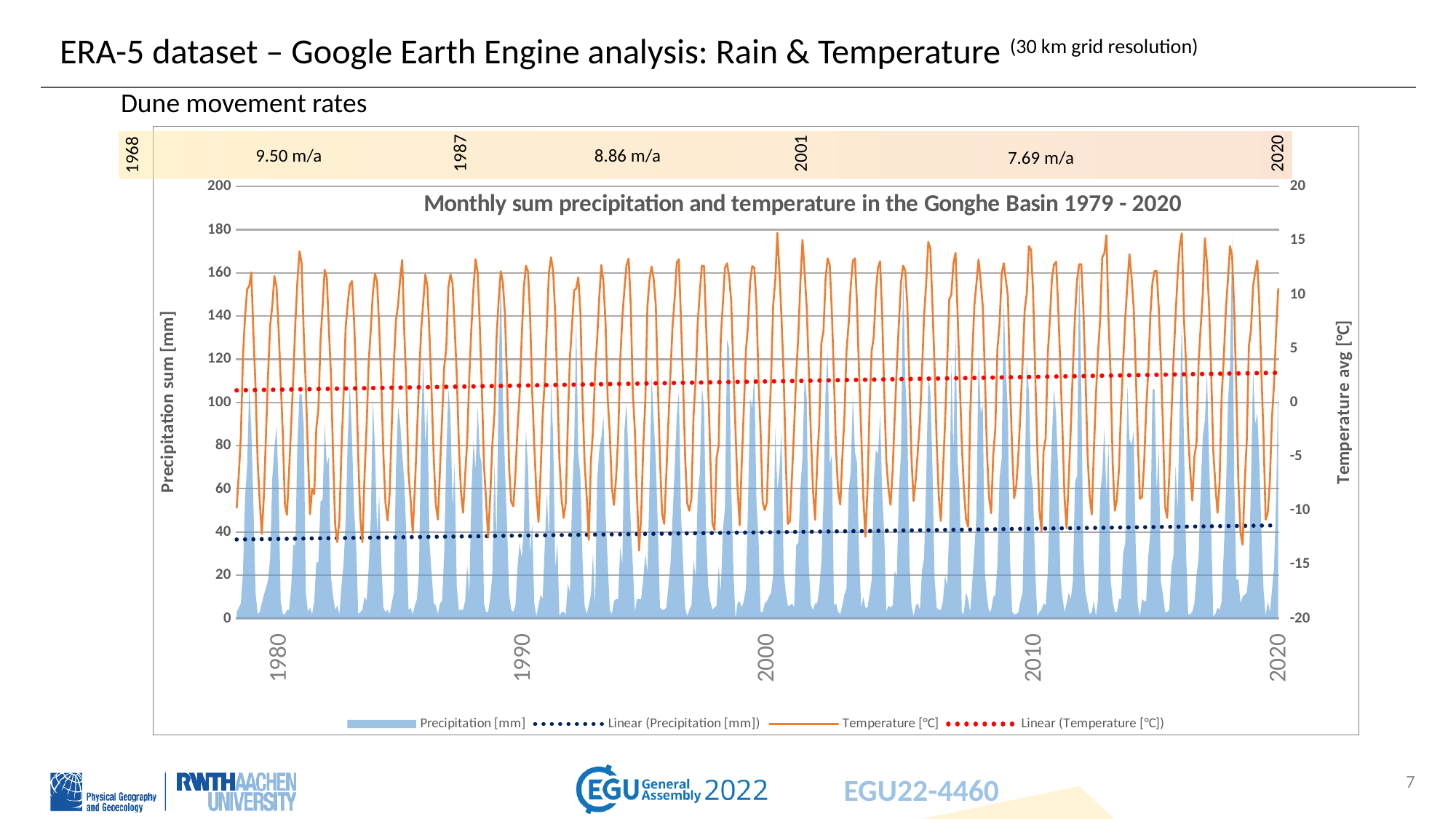
Does the linear temperature trend line rise or fall from 1980 to 2020? rise Is the value of the linear precipitation trend line in 1980 greater or less than 60 mm? less What dune movement rate is given for the period 1968 to 1987 above the chart? 9.50 m/a What is the title of the chart? Monthly sum precipitation and temperature in the Gonghe Basin 1979 - 2020 Is the highest monthly precipitation sum in the chart greater or less than 100 mm? greater Does the linear precipitation trend line rise or fall from 1980 to 2020? rise How many year labels are shown on the x axis? 5 What kind of chart is shown? combined area and line chart Is the value of the linear temperature trend line in 2020 greater or less than 0 °C? greater What is the label of the left vertical axis? Precipitation sum [mm] How many series does the chart legend list? 4